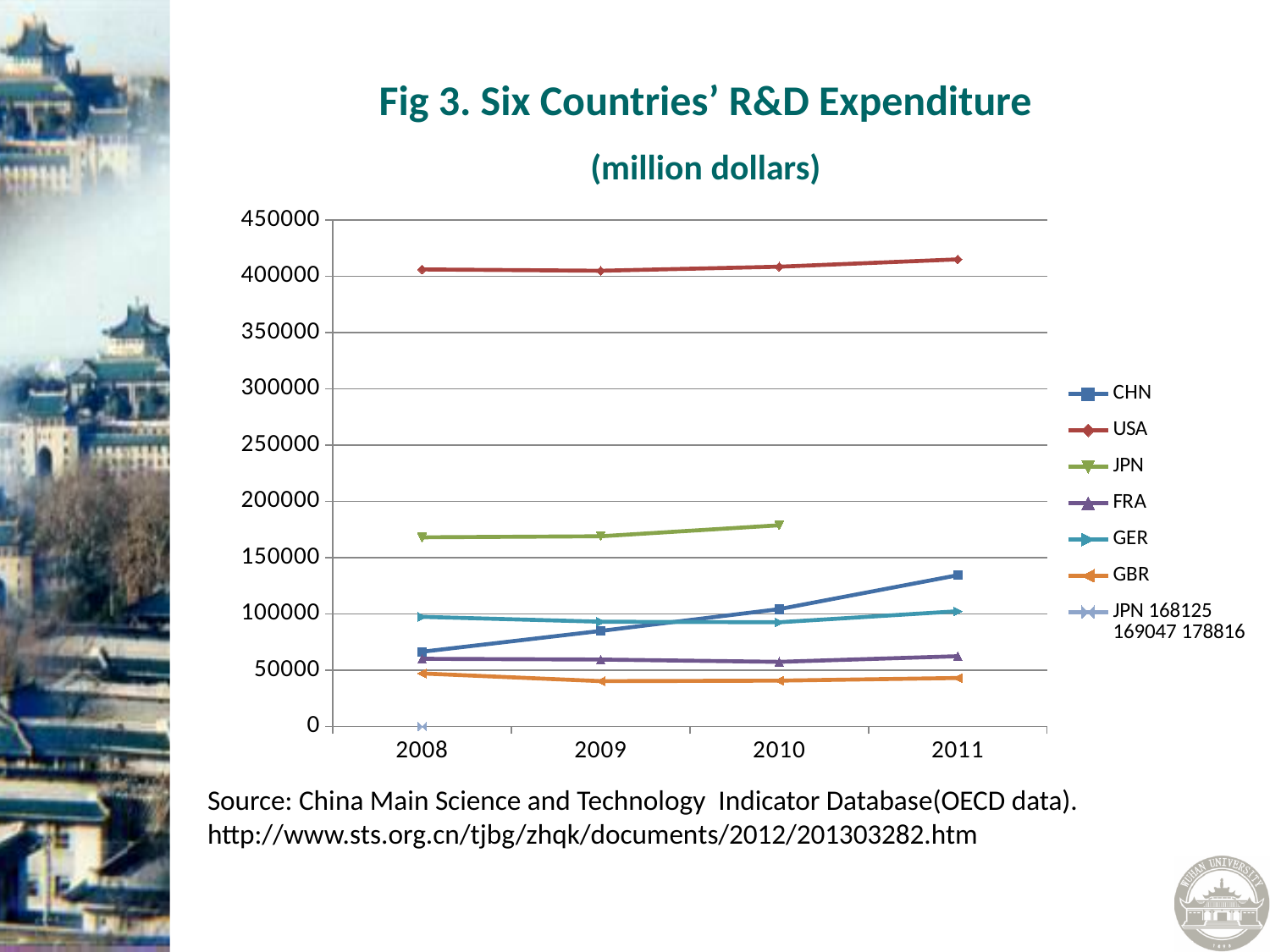
Which country has the highest R&D expenditure in every year shown? USA Is the value for GBR in 2009 greater or less than 50000? less What kind of chart is shown on the slide? line chart Which country has the lowest R&D expenditure in 2011? GBR What unit is given in the chart's subtitle? million dollars Is the value for USA in 2008 greater or less than 400000? greater Is the value for JPN in 2010 greater or less than 200000? less How many years are shown on the x axis? 4 Does the CHN line rise or fall from 2008 to 2011? rise Which is larger in 2011, the value for CHN or the value for GER? CHN How many series does the legend list? 7